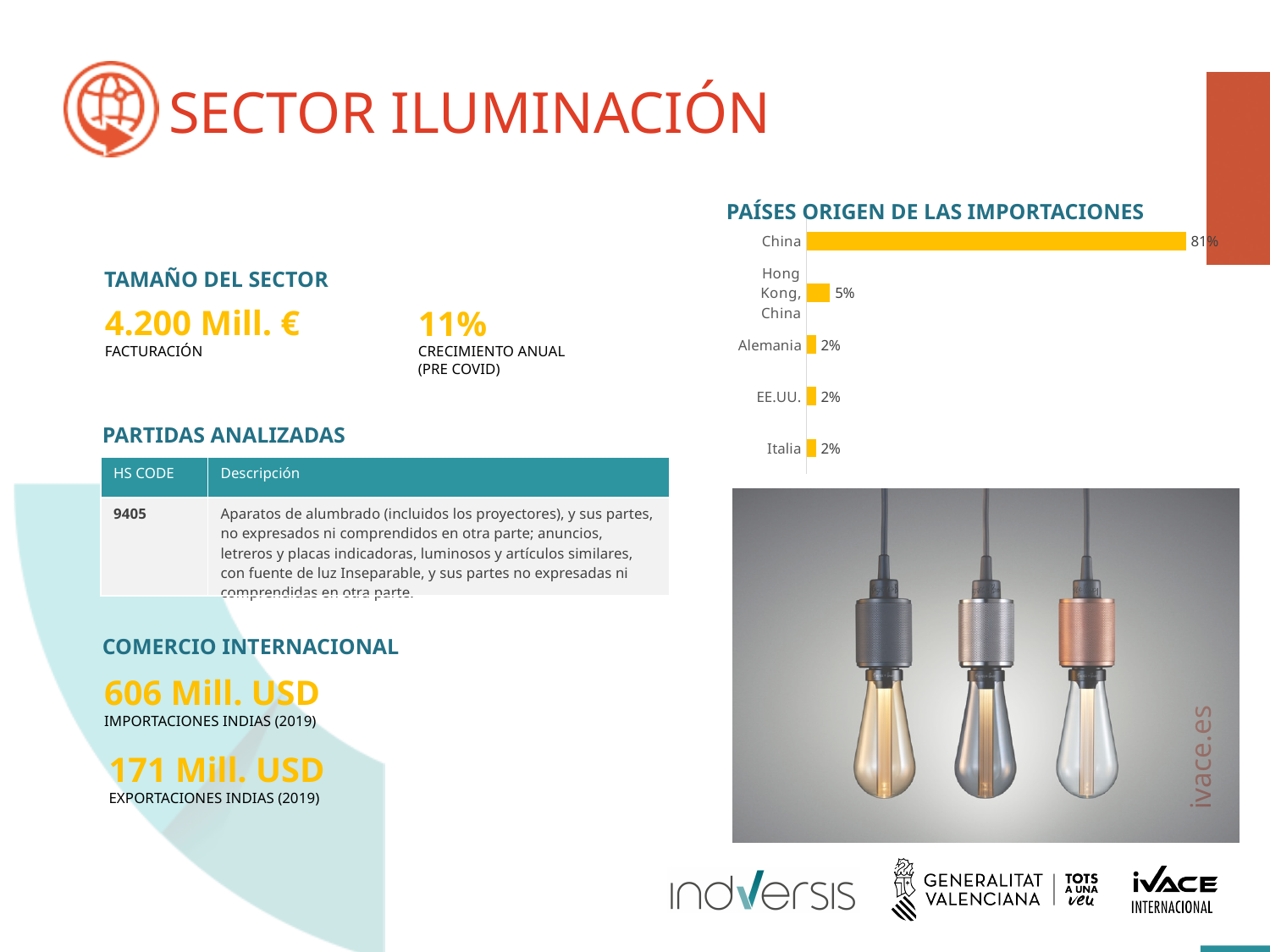
What is the value for Hong Kong, China in the 'PAÍSES ORIGEN DE LAS IMPORTACIONES' chart? 5% What is the difference between the values for China and Hong Kong, China in the 'PAÍSES ORIGEN DE LAS IMPORTACIONES' chart? 76% What kind of chart is 'PAÍSES ORIGEN DE LAS IMPORTACIONES'? Bar chart What colour are the bars in the 'PAÍSES ORIGEN DE LAS IMPORTACIONES' chart? Yellow What is the value for China in the 'PAÍSES ORIGEN DE LAS IMPORTACIONES' chart? 81% In the 'PAÍSES ORIGEN DE LAS IMPORTACIONES' chart, which is larger: the value for Hong Kong, China or the value for Italia? Hong Kong, China What is the value for Alemania in the 'PAÍSES ORIGEN DE LAS IMPORTACIONES' chart? 2% What is the difference between the values for Hong Kong, China and Alemania in the 'PAÍSES ORIGEN DE LAS IMPORTACIONES' chart? 3% Which country has the highest value in the 'PAÍSES ORIGEN DE LAS IMPORTACIONES' chart? China What is the title of the chart on the slide? PAÍSES ORIGEN DE LAS IMPORTACIONES How many countries are shown in the 'PAÍSES ORIGEN DE LAS IMPORTACIONES' chart? 5 What is the value for EE.UU. in the 'PAÍSES ORIGEN DE LAS IMPORTACIONES' chart? 2%